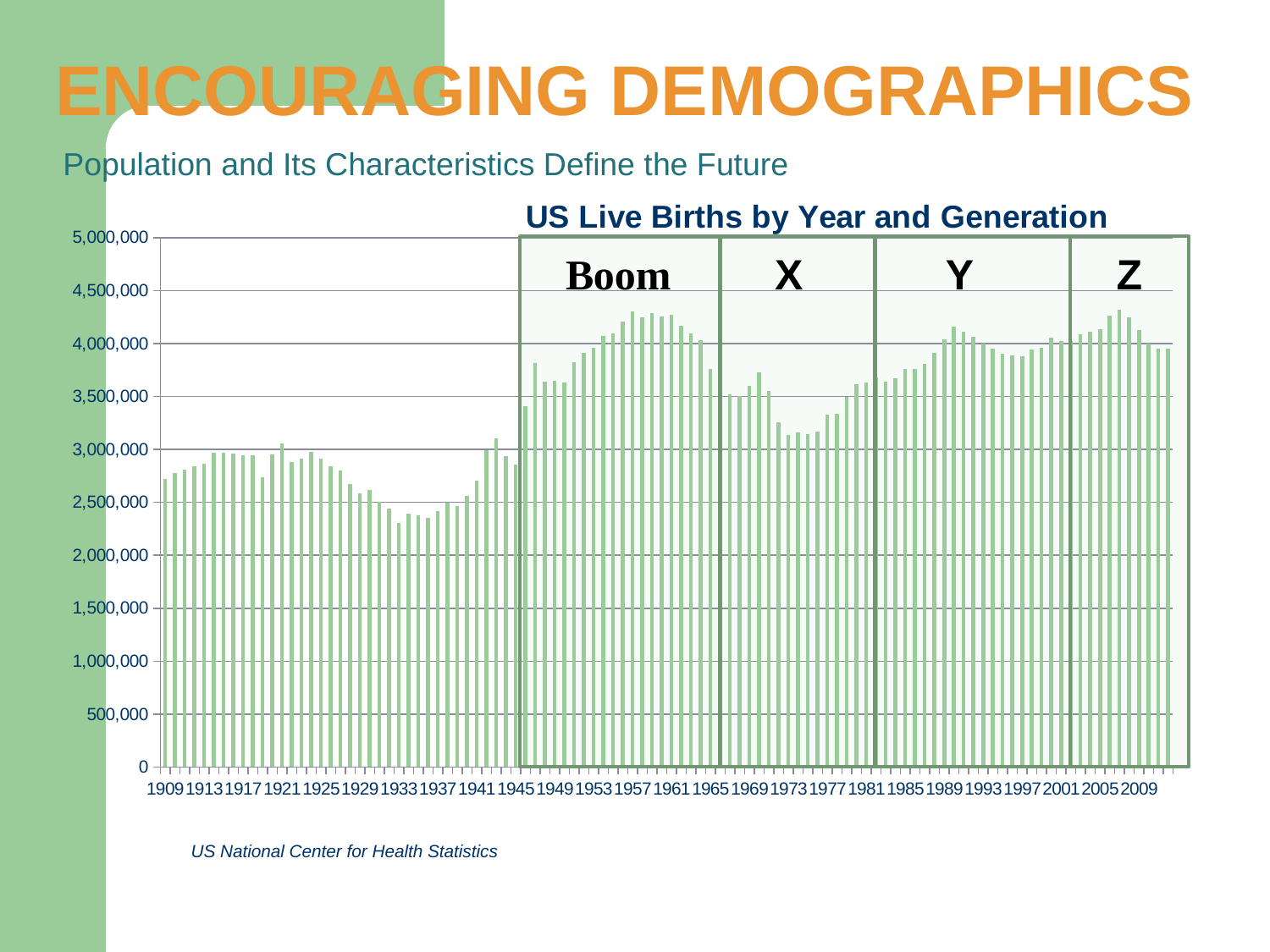
How many generation labels are marked on the chart? 4 What is the title of the chart? US Live Births by Year and Generation Which year has the lowest number of live births on the chart? 1933 Is the value for 1909 greater or less than 3,000,000? less Do the values rise or fall from 1957 to 1973? fall Is the value for 1957 greater or less than 4,000,000? greater Is the value for 1933 greater or less than 2,500,000? less What kind of chart is shown on the slide? bar chart Do the values rise or fall from 1973 to 1990? rise Which year has more live births, 1933 or 1957? 1957